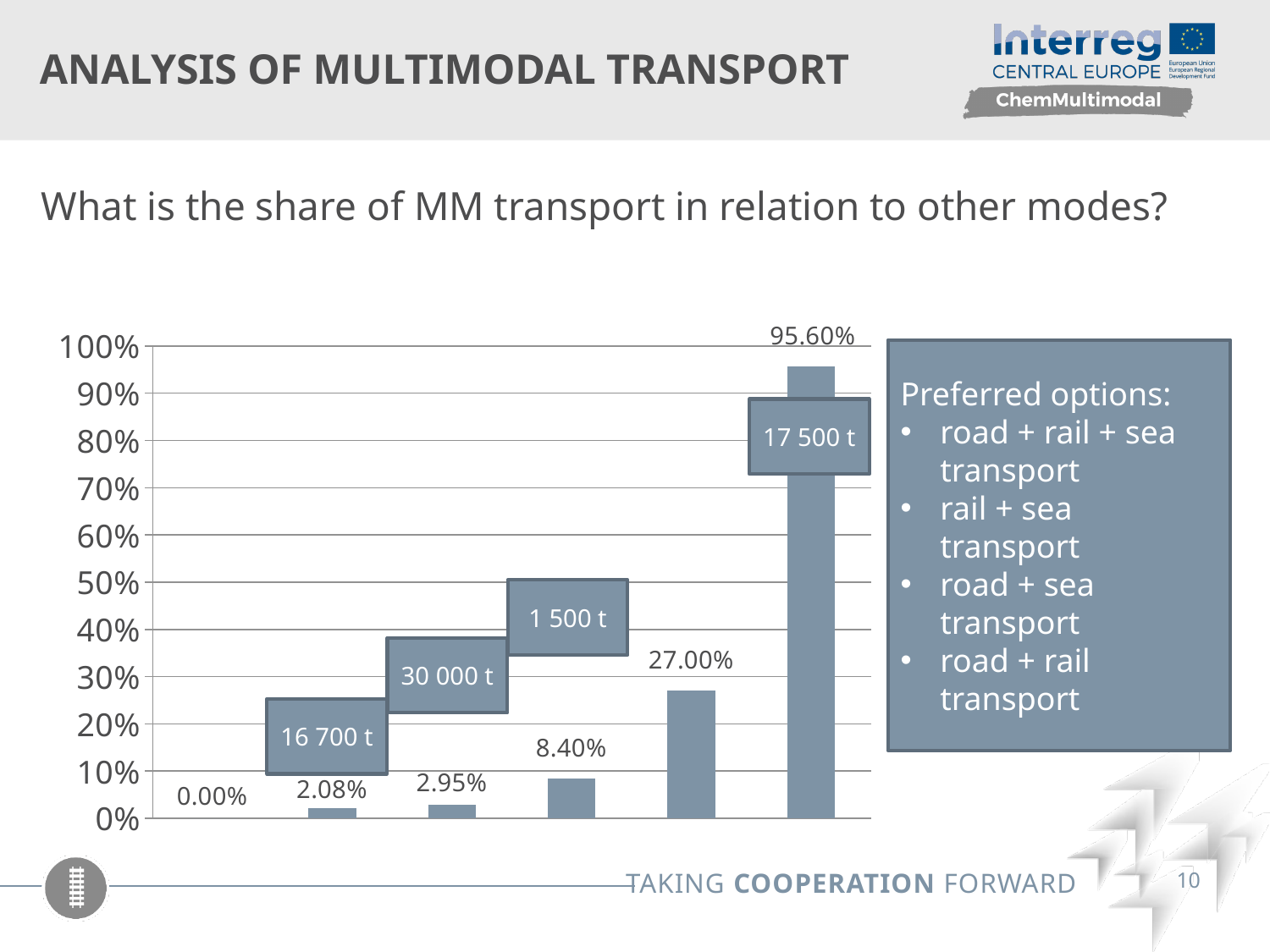
What is the value shown for the fifth bar from the left? 27.00% What is the value shown for the leftmost bar in the chart? 0.00% What is the value shown for the second bar from the left? 2.08% What is the difference between the rightmost bar (95.60%) and the fifth bar (27.00%)? 68.60% How many bars (data points) are plotted in the chart? 6 What is the lowest value shown in the chart? 0.00% What is the value shown for the rightmost bar in the chart? 95.60% What is the highest value shown in the chart? 95.60% Do the bar values rise or fall from left to right along the x axis? rise Is the value for the fifth bar from the left greater or less than 30%? less What kind of chart is shown on the slide? bar chart What is the value shown for the fourth bar from the left? 8.40%